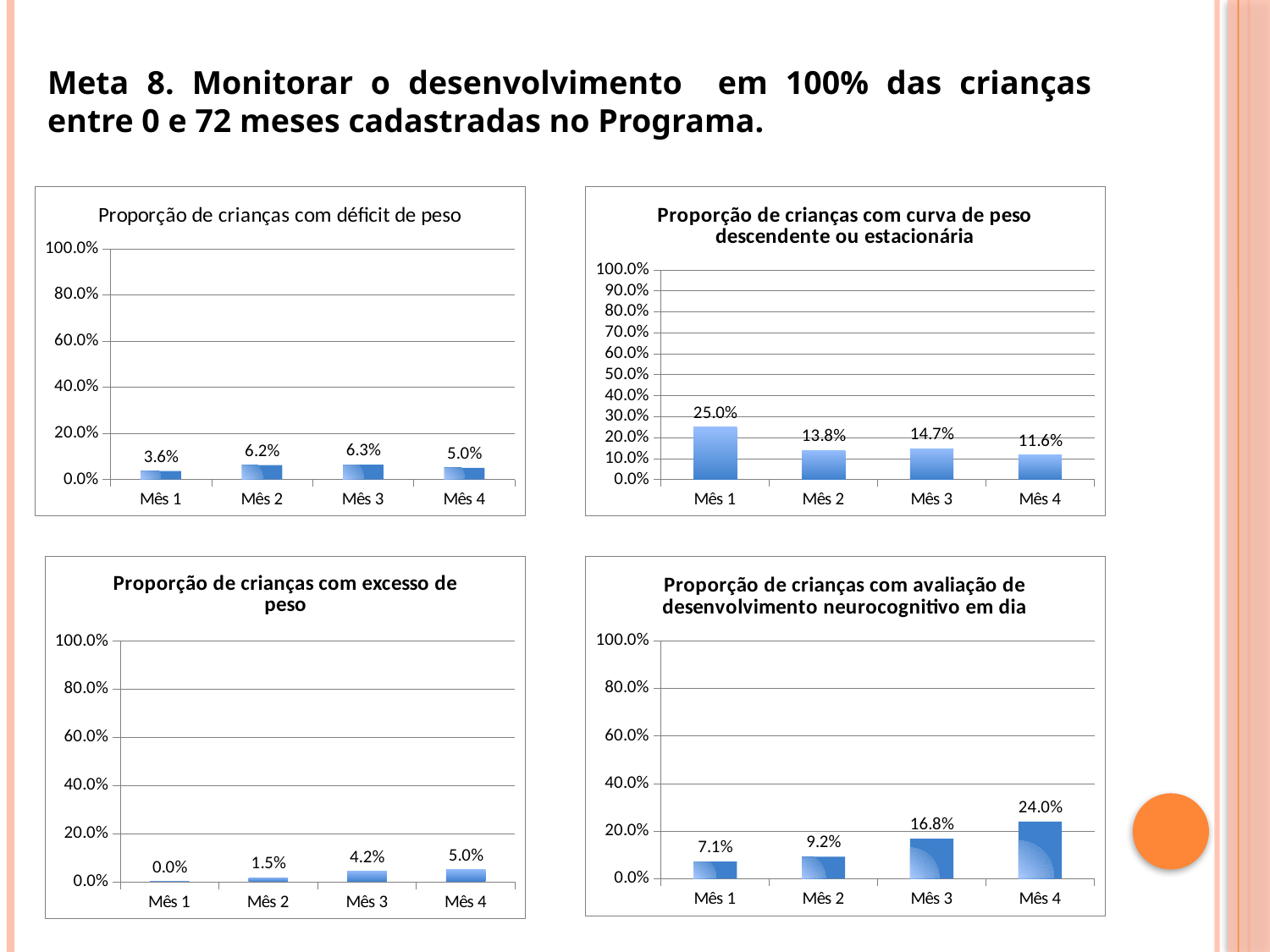
In the chart 'Proporção de crianças com déficit de peso', which month has the lowest value? Mês 1 In the chart 'Proporção de crianças com avaliação de desenvolvimento neurocognitivo em dia', what is the value for Mês 4? 24.0% In the chart 'Proporção de crianças com curva de peso descendente ou estacionária', what is the value for Mês 1? 25.0% In the chart 'Proporção de crianças com curva de peso descendente ou estacionária', which month has the highest value? Mês 1 In the chart 'Proporção de crianças com excesso de peso', what is the value for Mês 2? 1.5% How many months are shown on the x axis of the chart 'Proporção de crianças com déficit de peso'? 4 In the chart 'Proporção de crianças com excesso de peso', do the values rise or fall from Mês 1 to Mês 4? rise In the chart 'Proporção de crianças com curva de peso descendente ou estacionária', what is the difference between Mês 1 and Mês 4? 13.4% In the chart 'Proporção de crianças com déficit de peso', what is the value for Mês 3? 6.3% What type of chart is 'Proporção de crianças com excesso de peso'? bar chart In the chart 'Proporção de crianças com avaliação de desenvolvimento neurocognitivo em dia', what is the difference between Mês 4 and Mês 1? 16.9% In the chart 'Proporção de crianças com avaliação de desenvolvimento neurocognitivo em dia', which is larger, Mês 2 or Mês 3? Mês 3